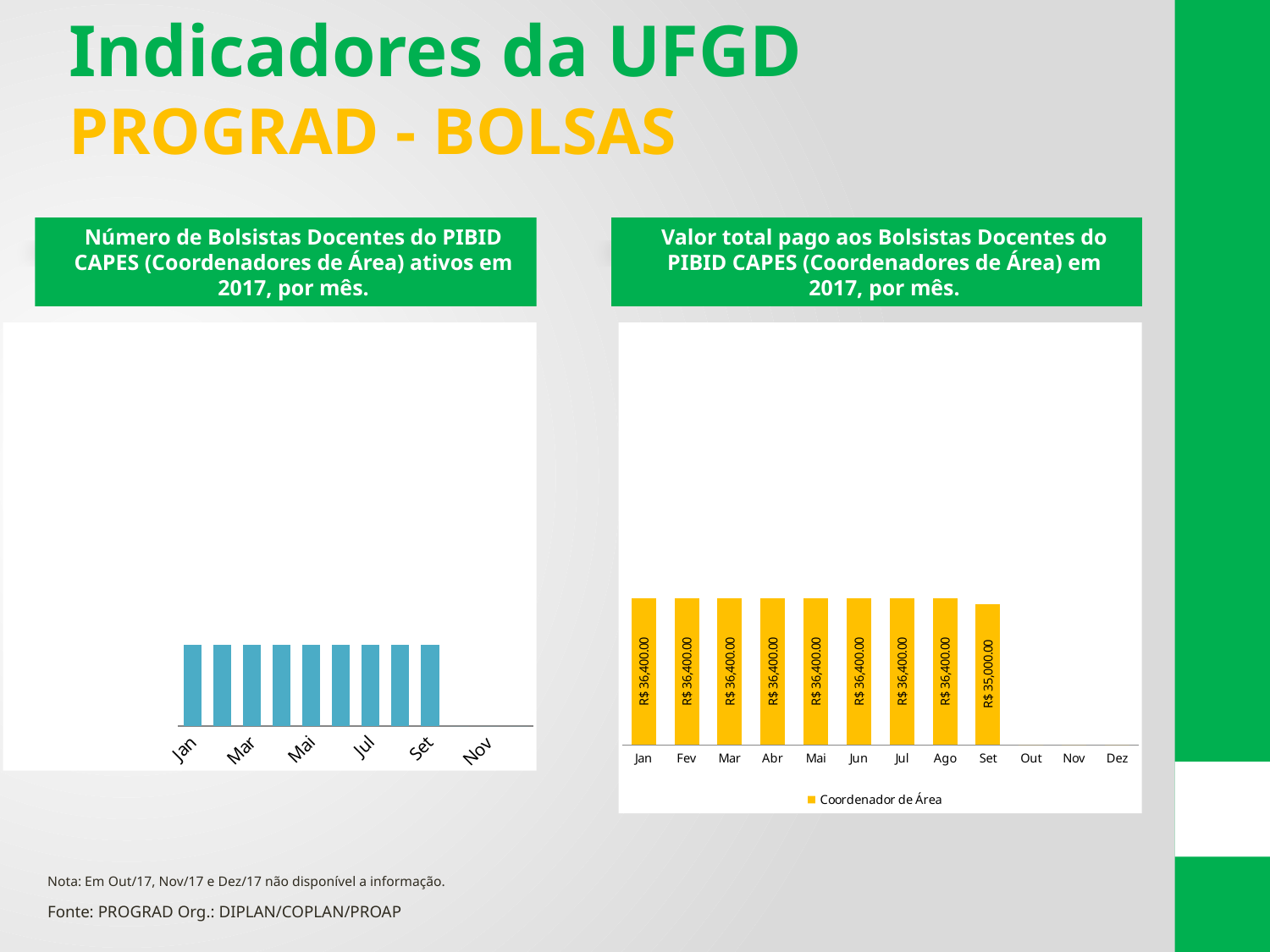
In the chart titled 'Valor total pago aos Bolsistas Docentes do PIBID CAPES (Coordenadores de Área) em 2017, por mês', how many months have a bar plotted? 9 In the chart titled 'Valor total pago aos Bolsistas Docentes do PIBID CAPES (Coordenadores de Área) em 2017, por mês', what is the legend entry? Coordenador de Área In the chart titled 'Valor total pago aos Bolsistas Docentes do PIBID CAPES (Coordenadores de Área) em 2017, por mês', how many months are listed on the x axis? 12 What kind of chart is the chart on the left of the slide, titled 'Número de Bolsistas Docentes do PIBID CAPES (Coordenadores de Área) ativos em 2017, por mês'? Bar chart In the chart titled 'Valor total pago aos Bolsistas Docentes do PIBID CAPES (Coordenadores de Área) em 2017, por mês', what is the value for Set? R$ 35,000.00 In the chart titled 'Valor total pago aos Bolsistas Docentes do PIBID CAPES (Coordenadores de Área) em 2017, por mês', what is the value for Mai? R$ 36,400.00 In the chart titled 'Valor total pago aos Bolsistas Docentes do PIBID CAPES (Coordenadores de Área) em 2017, por mês', which month with a plotted bar has the lowest value? Set In the chart on the left of the slide, titled 'Número de Bolsistas Docentes do PIBID CAPES (Coordenadores de Área) ativos em 2017, por mês', how many bars are plotted? 9 In the chart titled 'Valor total pago aos Bolsistas Docentes do PIBID CAPES (Coordenadores de Área) em 2017, por mês', what is the difference between the values for Ago and Set? R$ 1,400.00 In the chart titled 'Valor total pago aos Bolsistas Docentes do PIBID CAPES (Coordenadores de Área) em 2017, por mês', which is larger, the value for Jul or the value for Set? Jul In the chart titled 'Valor total pago aos Bolsistas Docentes do PIBID CAPES (Coordenadores de Área) em 2017, por mês', how many series does the legend list? 1 In the chart titled 'Valor total pago aos Bolsistas Docentes do PIBID CAPES (Coordenadores de Área) em 2017, por mês', what is the value for Jan? R$ 36,400.00